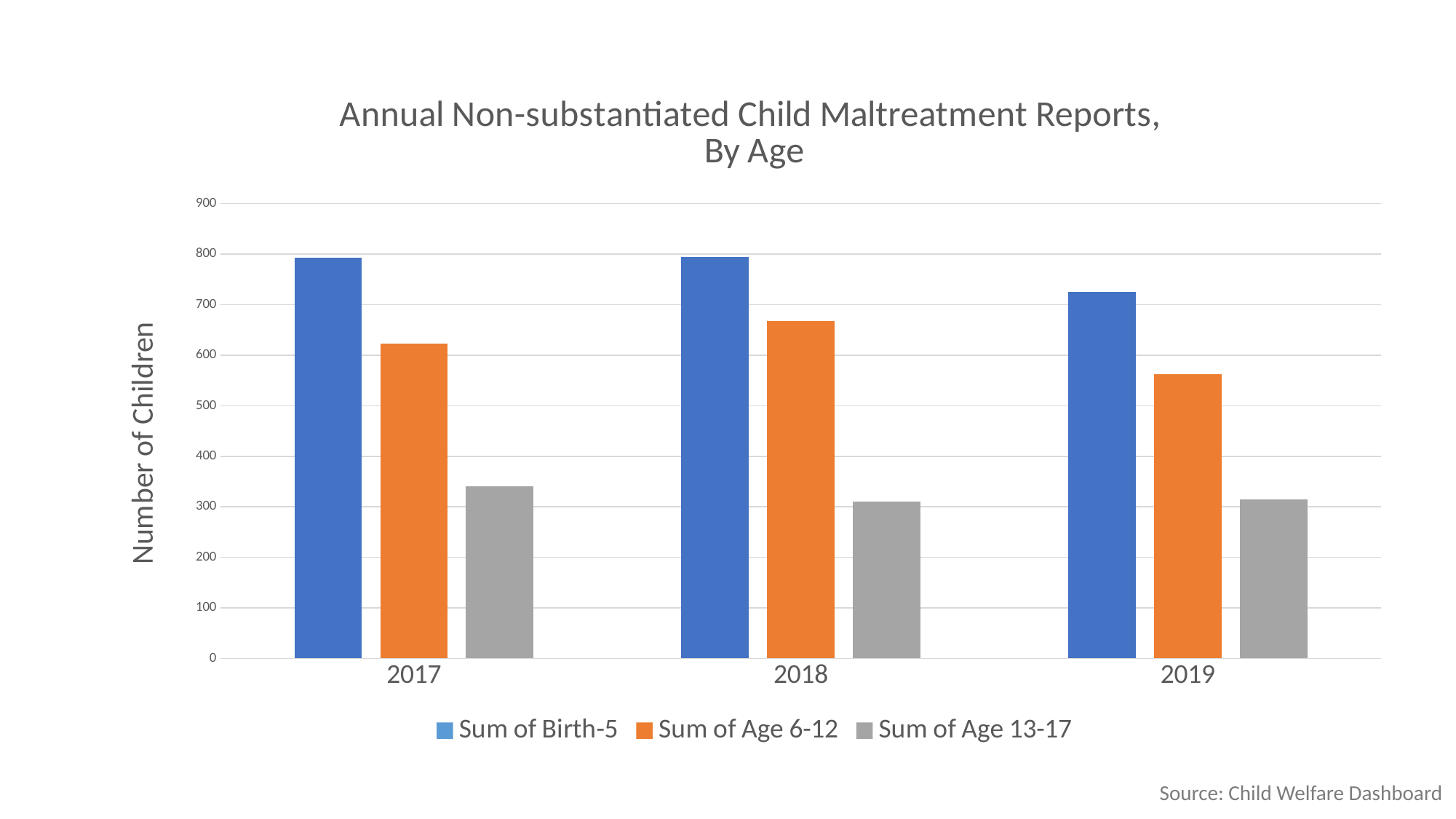
What kind of chart is shown on the slide? bar chart Does Sum of Age 6-12 rise or fall from 2018 to 2019? fall How many series does the legend list? 3 Is the value for Sum of Age 6-12 in 2019 greater or less than 600? less Which is larger in 2019, Sum of Birth-5 or Sum of Age 6-12? Sum of Birth-5 How many years are shown on the x axis? 3 In which year is Sum of Birth-5 lowest? 2019 Is the value for Sum of Age 6-12 in 2018 greater or less than 600? greater Is the value for Sum of Birth-5 in 2017 greater or less than 700? greater In which year is Sum of Age 6-12 highest? 2018 What is the label on the vertical axis? Number of Children